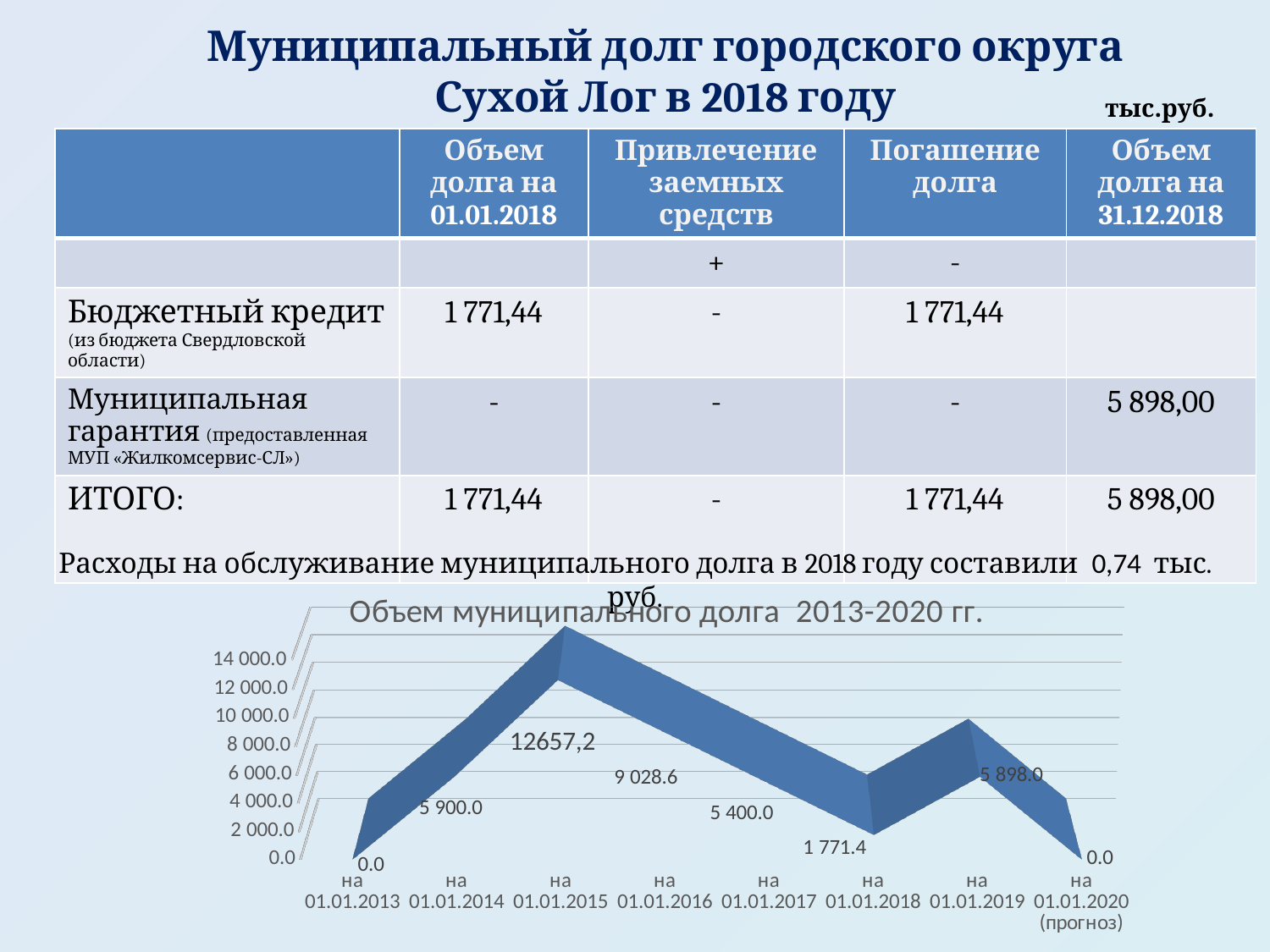
What kind of chart is shown on the slide? line chart How many data points are plotted on the chart? 8 What is the value for на 01.01.2015? 12657,2 What is the value for на 01.01.2019? 5 898.0 What is the value for на 01.01.2014? 5 900.0 Which is larger, the value for на 01.01.2016 or the value for на 01.01.2017? на 01.01.2016 What is the title of the chart? Объем муниципального долга 2013-2020 гг. What is the value for на 01.01.2016? 9 028.6 What is the value for на 01.01.2018? 1 771.4 What is the difference between the values for на 01.01.2017 and на 01.01.2018? 3 628.6 Do the values rise or fall from на 01.01.2015 to на 01.01.2018? fall Which date has the highest value on the chart? на 01.01.2015